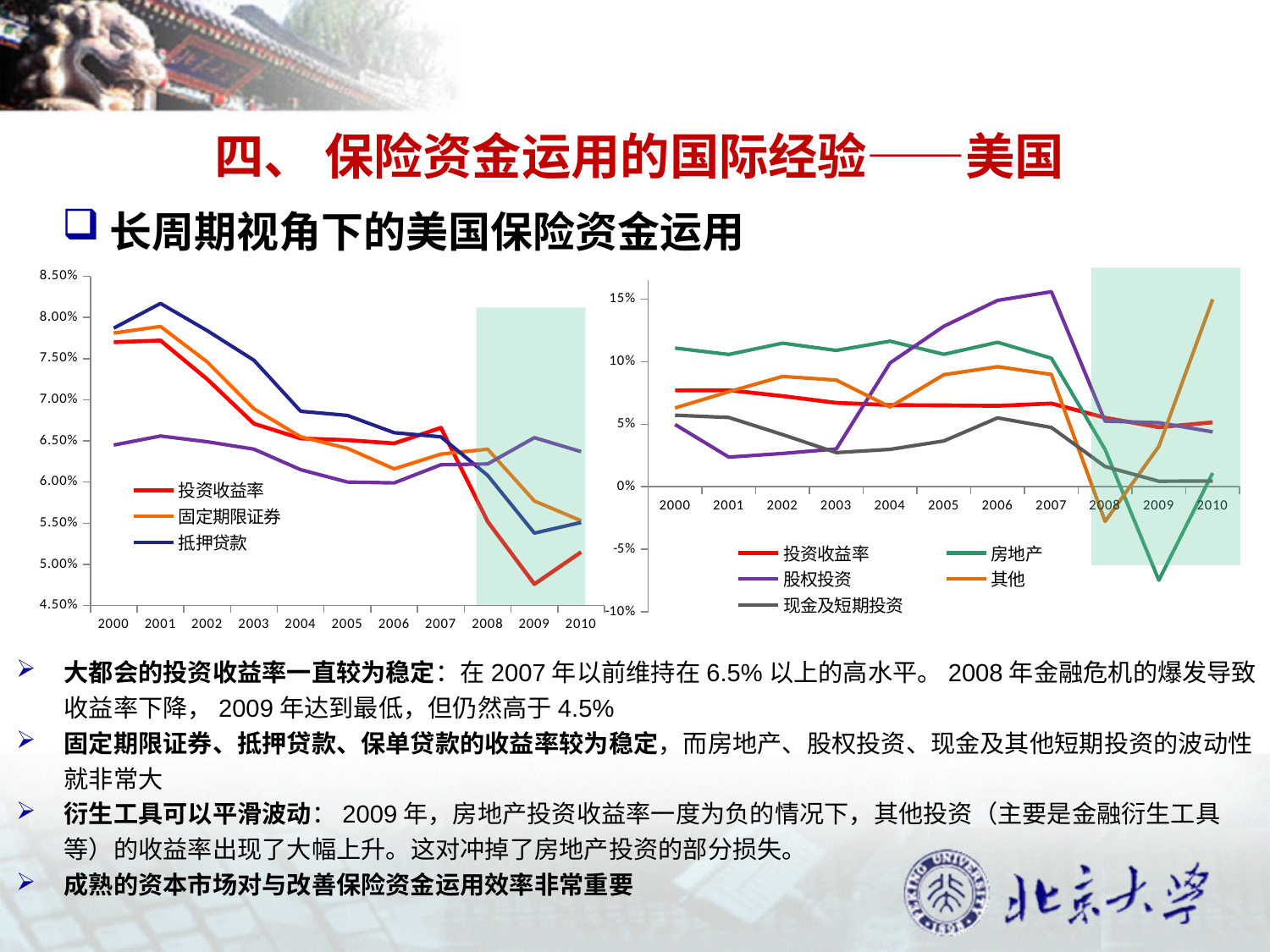
In the left chart, in which year is 投资收益率 at its lowest? 2009 In the right chart, is the value of 房地产 in 2009 greater or less than -5%? less How many series does the legend of the left chart list? 3 In the right chart, in which year does 其他 reach its highest value? 2010 How many series does the legend of the right chart list? 5 In the right chart, is the value of 其他 in 2010 greater or less than 10%? greater In the left chart, is the value of 抵押贷款 in 2001 greater or less than 8.00%? greater What kind of chart is the chart on the left of the slide? line chart In the left chart, does 投资收益率 rise or fall from 2000 to 2009? fall In the right chart, which series has the lowest value in 2009? 房地产 How many years are shown on the x axis of the right chart? 11